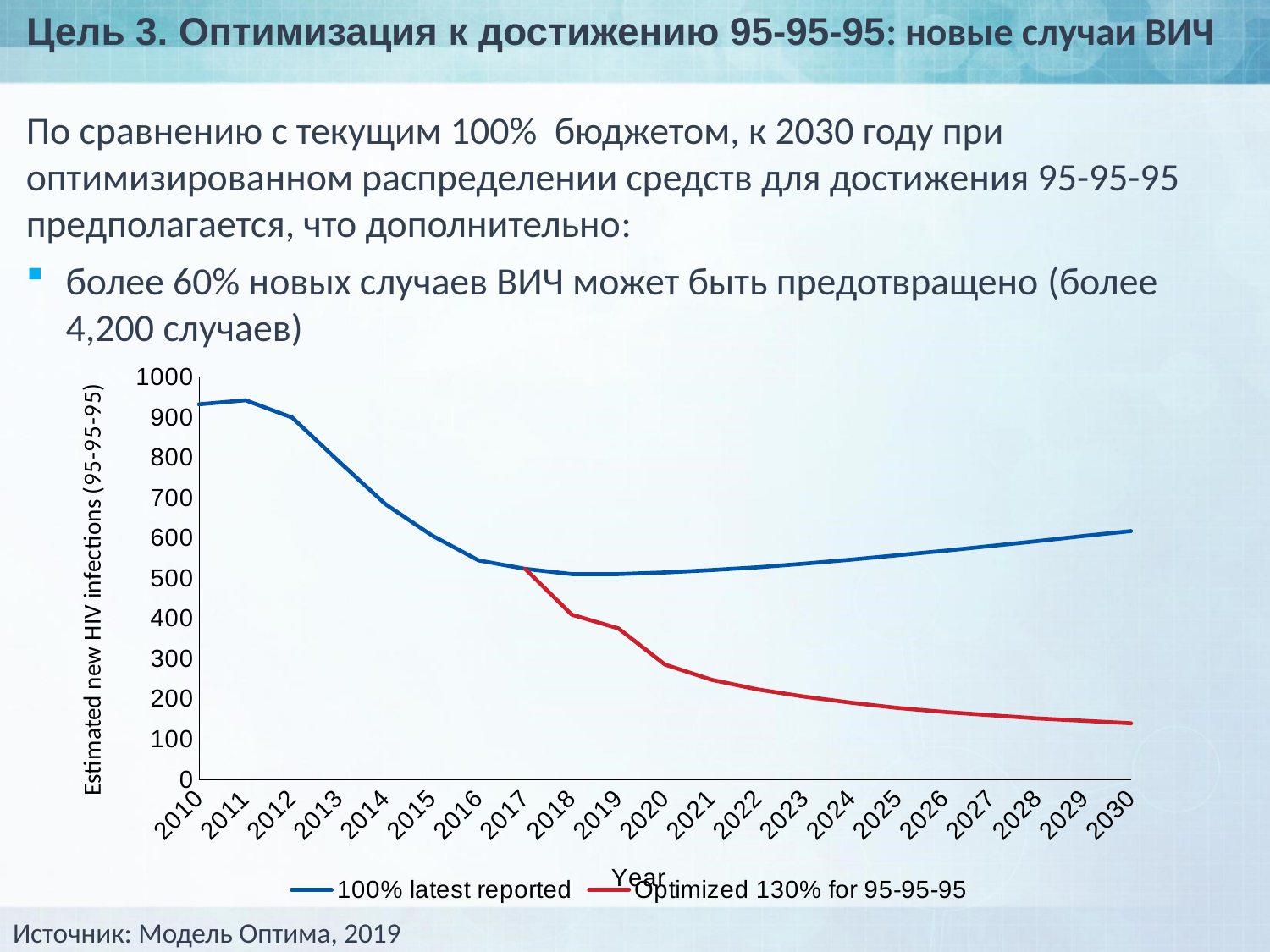
Does the 'Optimized 130% for 95-95-95' series rise or fall from 2017 to 2030? fall Is the value of the '100% latest reported' series in 2030 greater or less than 500? greater In 2030, which series has the higher value: '100% latest reported' or 'Optimized 130% for 95-95-95'? 100% latest reported Is the value of the 'Optimized 130% for 95-95-95' series in 2022 greater or less than 300? less What kind of chart is shown on the slide? line chart Is the value of the '100% latest reported' series in 2010 greater or less than 900? greater Does the '100% latest reported' series rise or fall from 2020 to 2030? rise What is the label of the chart's y axis? Estimated new HIV infections (95-95-95) How many series does the chart legend list? 2 How many years are shown along the x axis of the chart? 21